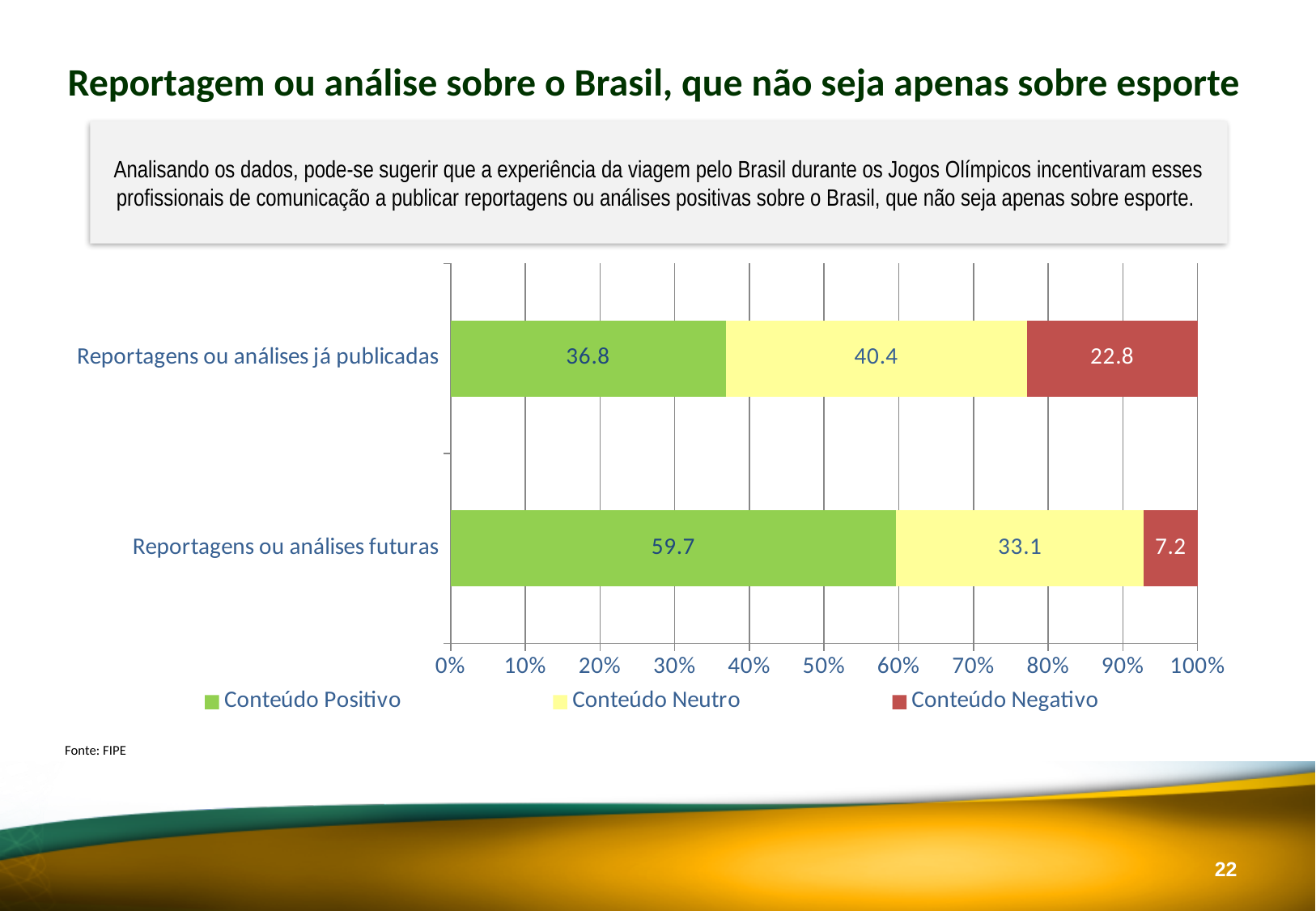
Which category has the lower Conteúdo Negativo value? Reportagens ou análises futuras Which colour represents Conteúdo Negativo in the chart? Red What is the difference in Conteúdo Positivo between Reportagens ou análises futuras and Reportagens ou análises já publicadas? 22.9 What is the value of Conteúdo Positivo for Reportagens ou análises futuras? 59.7 What kind of chart is shown on the slide? Stacked bar chart Is the Conteúdo Neutro value larger for Reportagens ou análises já publicadas or for Reportagens ou análises futuras? Reportagens ou análises já publicadas How many series does the legend list? 3 What is the value of Conteúdo Negativo for Reportagens ou análises já publicadas? 22.8 How many categories are shown on the chart? 2 Which category has the higher Conteúdo Positivo value? Reportagens ou análises futuras What is the value of Conteúdo Positivo for Reportagens ou análises já publicadas? 36.8 What is the value of Conteúdo Neutro for Reportagens ou análises futuras? 33.1